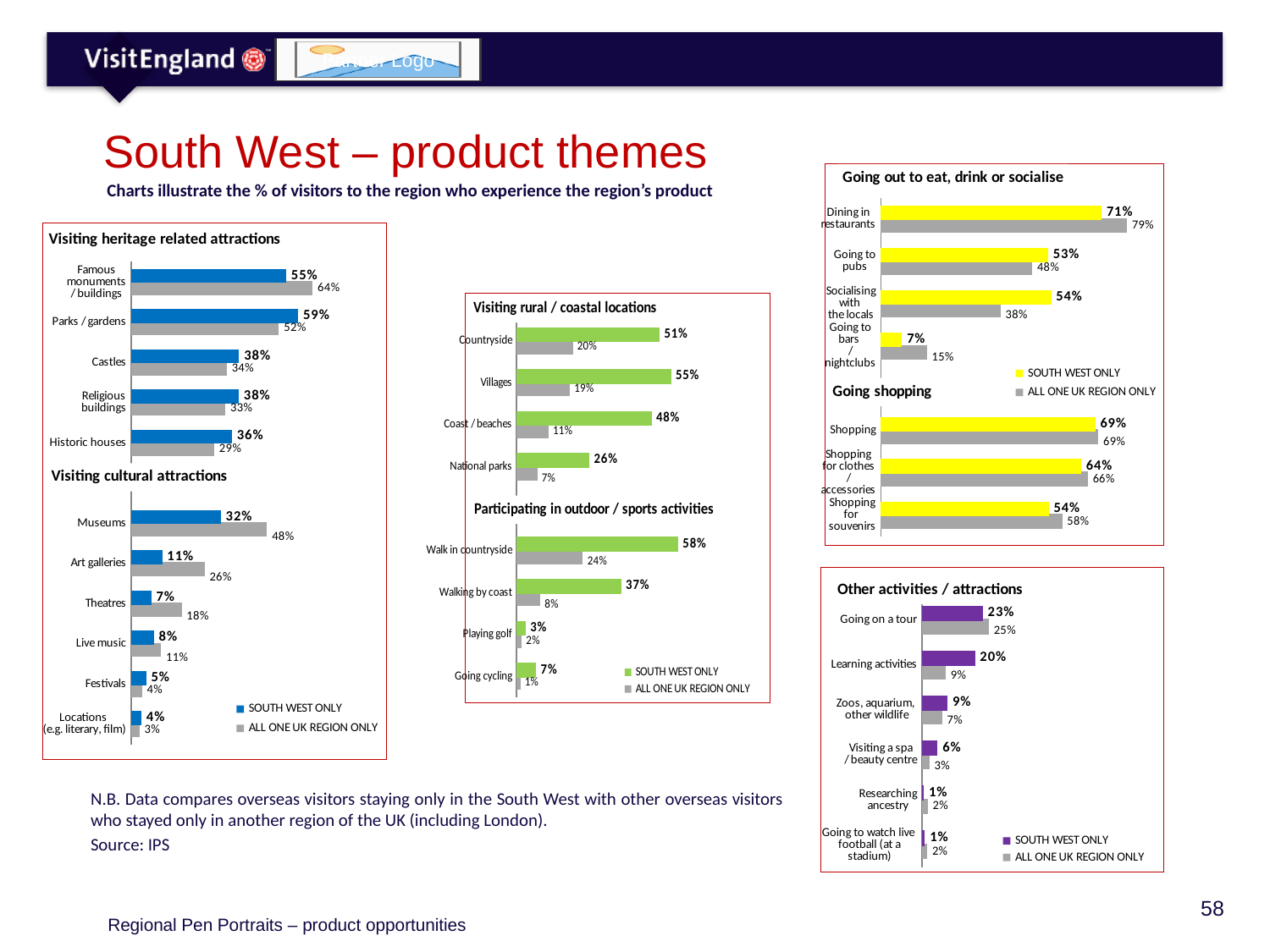
In the 'Visiting rural / coastal locations' chart, which category has the lowest SOUTH WEST ONLY value? National parks In the 'Going out to eat, drink or socialise' chart, what is the SOUTH WEST ONLY value for Going to bars / nightclubs? 7% In the 'Visiting heritage related attractions' chart, what is the SOUTH WEST ONLY value for Parks / gardens? 59% In the 'Visiting heritage related attractions' chart, what is the ALL ONE UK REGION ONLY value for Famous monuments / buildings? 64% How many series does the legend list in the 'Other activities / attractions' chart? 2 In the 'Visiting cultural attractions' chart, what is the difference between the ALL ONE UK REGION ONLY and SOUTH WEST ONLY values for Art galleries? 15% In the 'Visiting cultural attractions' chart, which category has the highest SOUTH WEST ONLY value? Museums In the 'Visiting rural / coastal locations' chart, what is the SOUTH WEST ONLY value for Coast / beaches? 48% In the 'Participating in outdoor / sports activities' chart, how many categories are shown? 4 In the 'Going out to eat, drink or socialise' chart, which is larger for Dining in restaurants: the SOUTH WEST ONLY value or the ALL ONE UK REGION ONLY value? ALL ONE UK REGION ONLY In the 'Other activities / attractions' chart, what is the difference between the SOUTH WEST ONLY and ALL ONE UK REGION ONLY values for Learning activities? 11% In the 'Going shopping' chart, what is the ALL ONE UK REGION ONLY value for Shopping for souvenirs? 58%